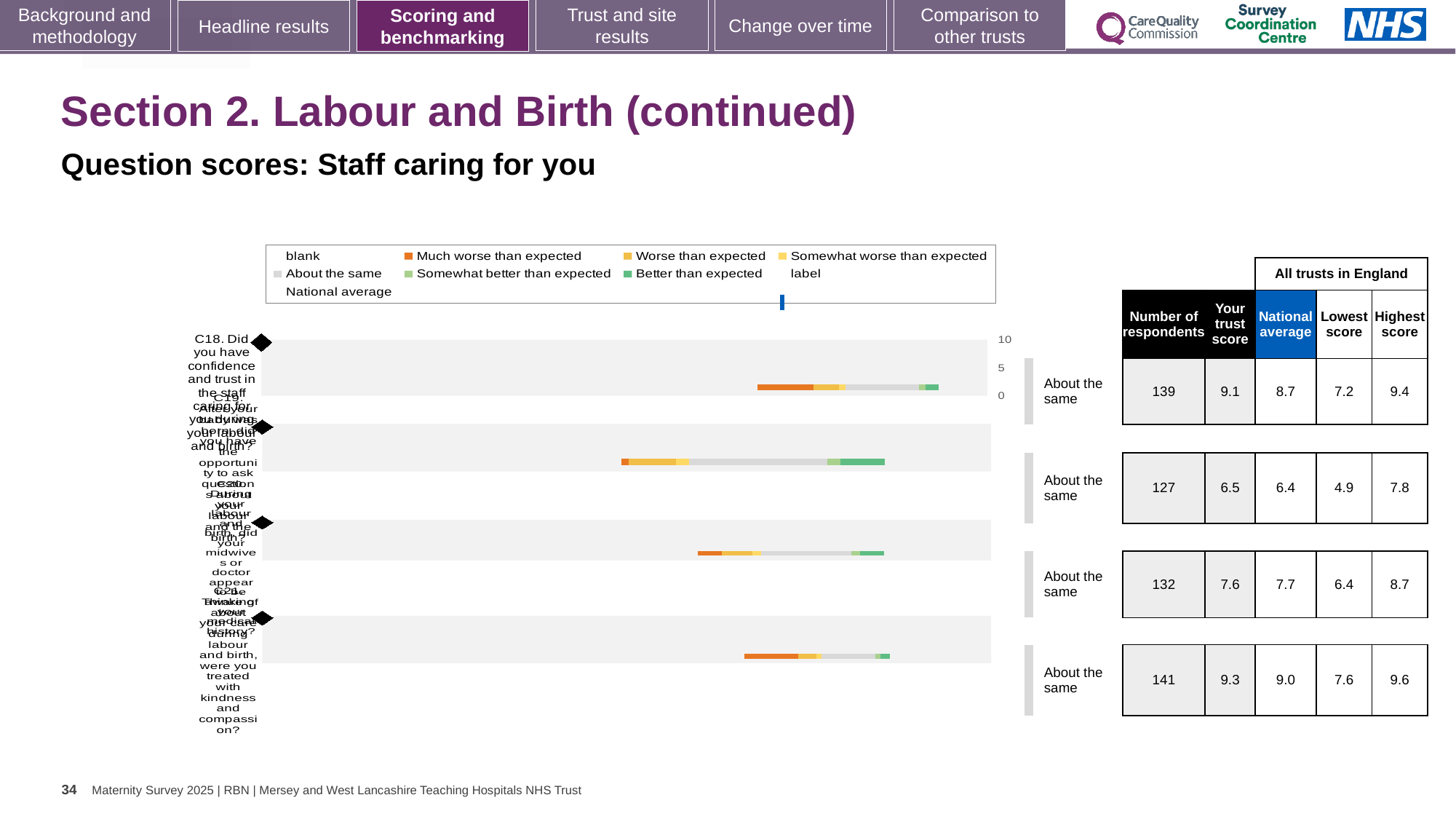
In the table beside the chart, what is the lowest score across all trusts in England for the second question (C19)? 4.9 In the table beside the chart, what is the 'Your trust score' for the second question (C19)? 6.5 Which question has the highest 'Your trust score' in the table beside the chart? C21 For the third question (C20), which is larger: 'Your trust score' or the national average? National average In the table beside the chart, what is the number of respondents for the first question (C18)? 139 In the table beside the chart, what is the highest score across all trusts in England for the first question (C18)? 9.4 What benchmark category is shown next to each of the four bars? About the same What kind of chart is shown on the slide? bar chart Which question has the lowest 'Your trust score' in the table beside the chart? C19 How many question bars are plotted in the chart? 4 For the fourth question (C21), what is the difference between 'Your trust score' and the national average? 0.3 In the chart legend, what colour represents 'Much worse than expected'? orange